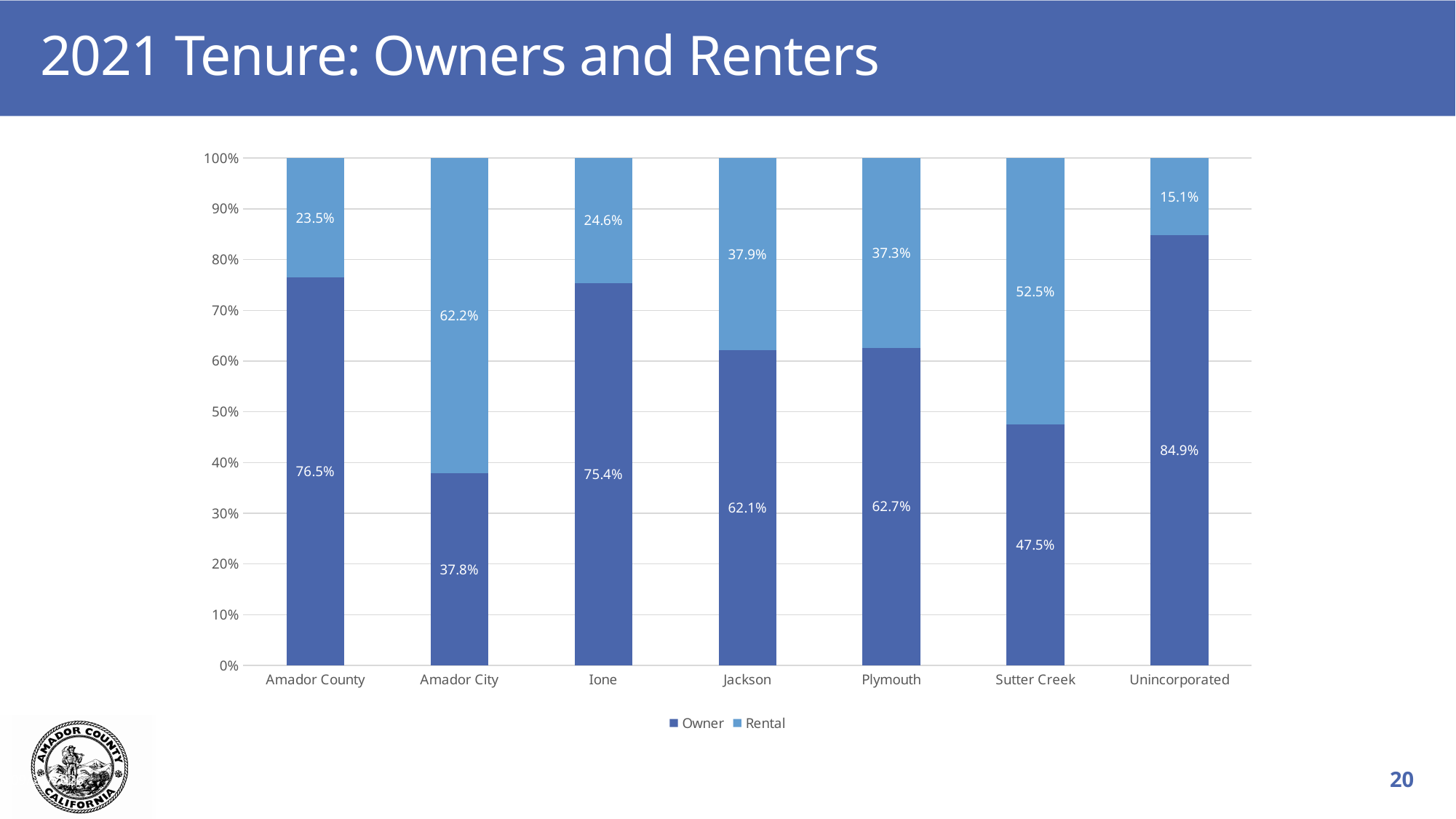
How many series does the legend list? 2 What is the difference between the Owner share for Ione and the Owner share for Jackson? 13.3% What is the Owner share for Unincorporated? 84.9% Which is larger: the Rental share for Plymouth or the Rental share for Ione? Plymouth Which category has the highest Rental share? Amador City What kind of chart is shown on the slide? Stacked bar chart What is the Rental share for Jackson? 37.9% What is the Rental share for Sutter Creek? 52.5% Which category has the highest Owner share? Unincorporated Which category has the lowest Owner share? Amador City What is the Owner share for Amador County? 76.5% How many categories are shown on the x axis? 7